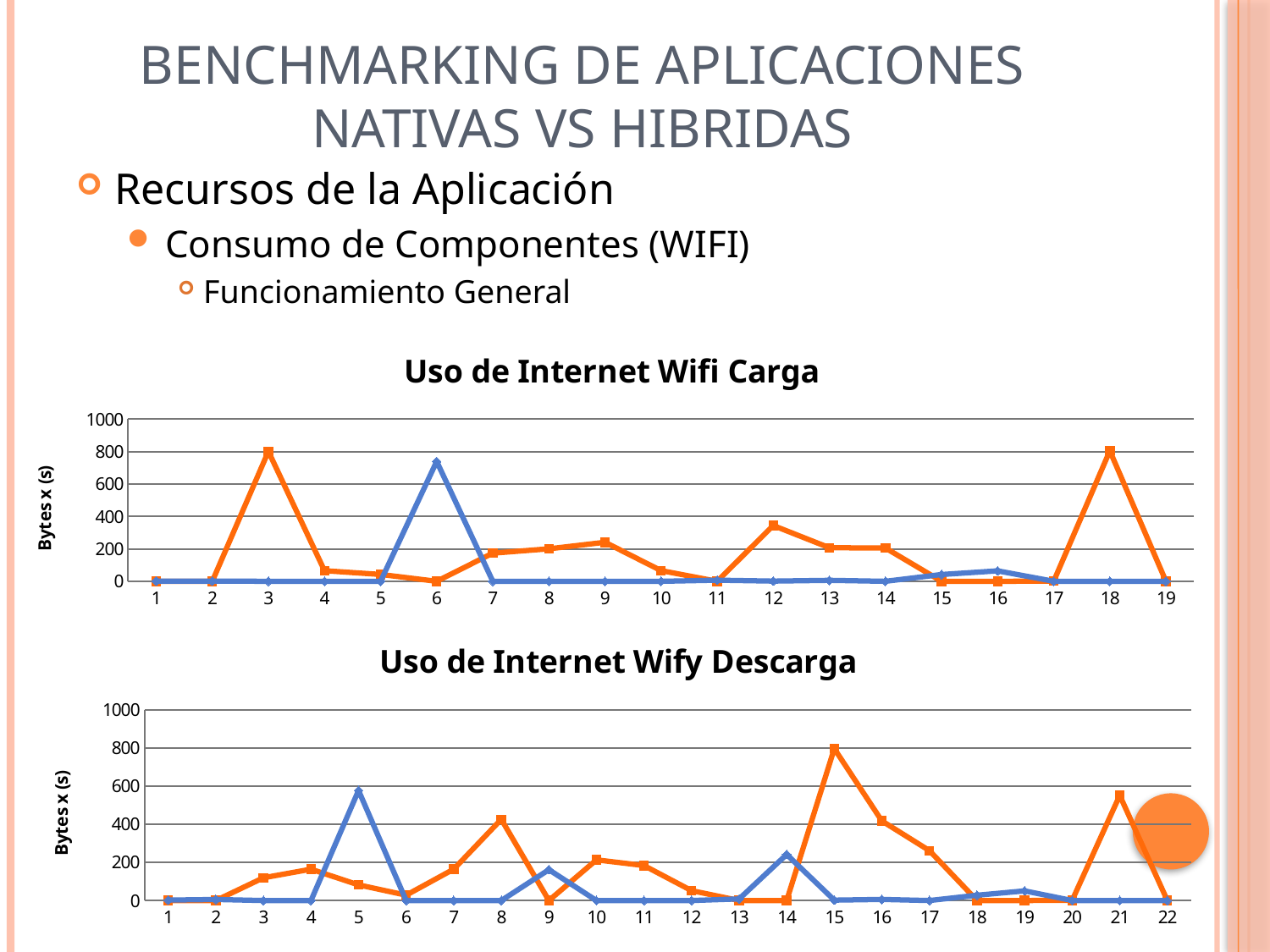
In the "Uso de Internet Wify Descarga" chart, at which x-axis point does the blue line reach its highest value? 5 In the "Uso de Internet Wify Descarga" chart, is the value of the blue line at point 5 greater or less than 400? greater In the "Uso de Internet Wifi Carga" chart, at which x-axis point does the blue line reach its highest value? 6 In the "Uso de Internet Wifi Carga" chart, at point 12, which line has the larger value, the orange line or the blue line? orange line In the "Uso de Internet Wify Descarga" chart, is the value of the orange line at point 15 greater or less than 600? greater In the "Uso de Internet Wifi Carga" chart, how many points are labelled on the x axis? 19 In the "Uso de Internet Wify Descarga" chart, at which x-axis point does the orange line reach its highest value? 15 What is the y-axis label of the "Uso de Internet Wify Descarga" chart? Bytes x (s) In the "Uso de Internet Wifi Carga" chart, is the value of the orange line at point 3 greater or less than 600? greater In the "Uso de Internet Wify Descarga" chart, how many points are labelled on the x axis? 22 What kind of chart is "Uso de Internet Wifi Carga"? line chart